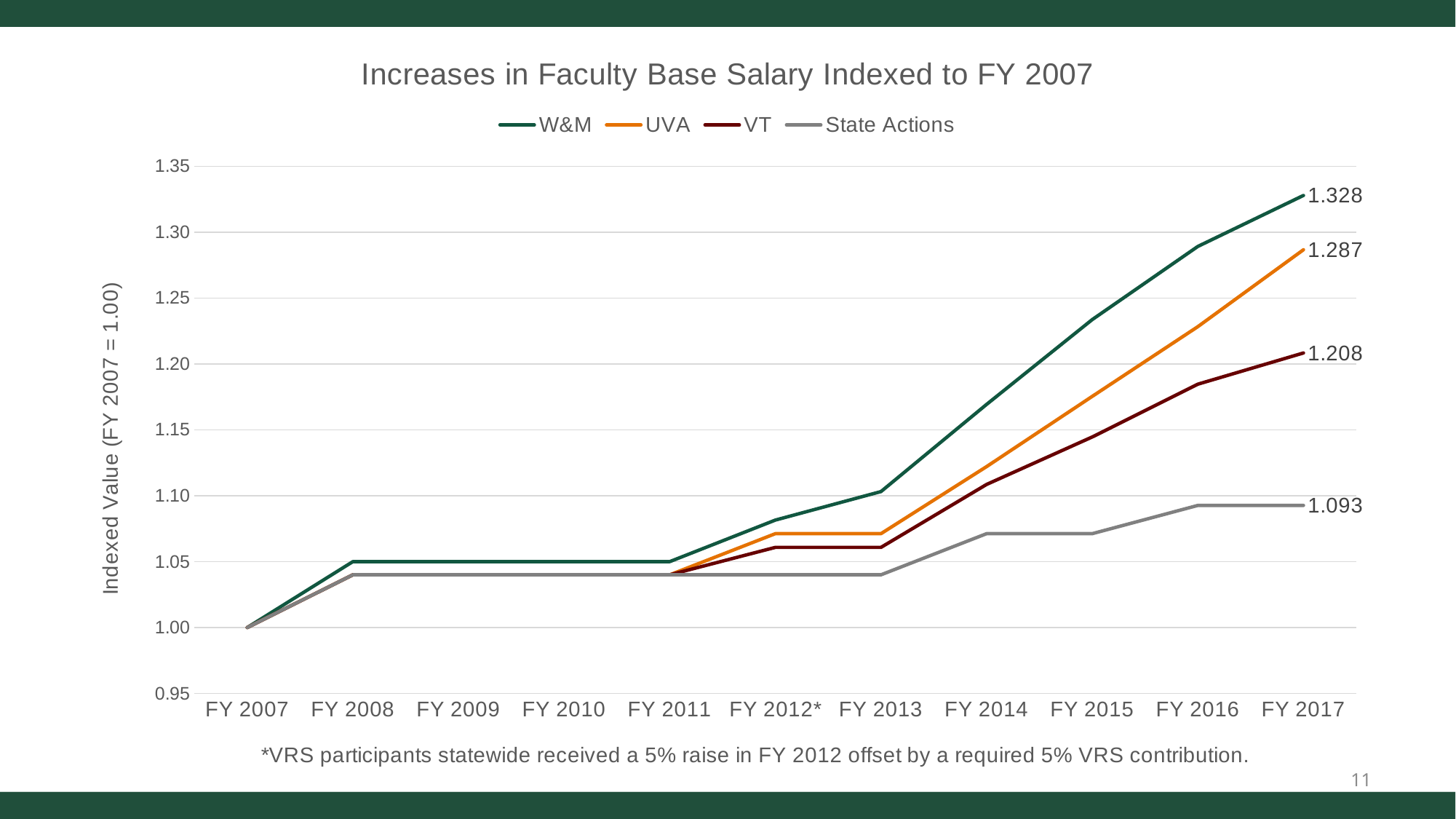
Is the State Actions value in FY 2014 greater or less than 1.10? less Which series has the highest indexed value in FY 2017? W&M What kind of chart is shown on the slide? line chart What is the indexed value for UVA in FY 2017? 1.287 How many fiscal years are plotted along the x axis? 11 What is the indexed value for VT in FY 2017? 1.208 What is the difference between the W&M and UVA indexed values in FY 2017? 0.041 How many series does the legend list? 4 What is the indexed value for W&M in FY 2017? 1.328 Which series has the lowest indexed value in FY 2017? State Actions What is the title of the chart? Increases in Faculty Base Salary Indexed to FY 2007 What is the indexed value for State Actions in FY 2017? 1.093